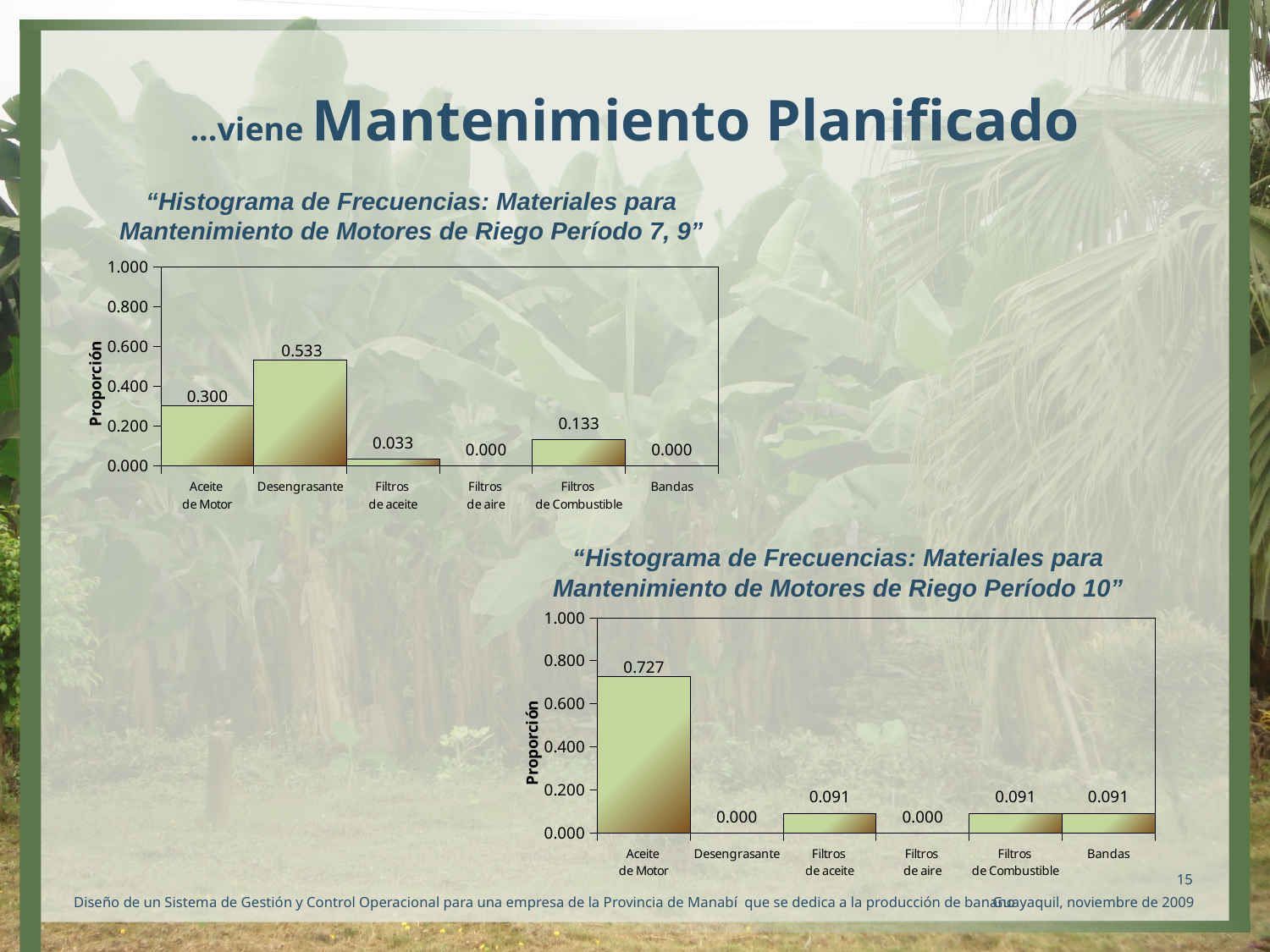
In the Período 7, 9 chart (top), which category has the highest proportion? Desengrasante In the Período 7, 9 chart (top), how many categories are shown on the x axis? 6 In the Período 10 chart (bottom), which category has the highest proportion? Aceite de Motor Which is larger: the proportion for Aceite de Motor in the Período 7, 9 chart or in the Período 10 chart? Período 10 chart In the Período 10 chart (bottom), is the proportion for Aceite de Motor greater or less than 0.600? greater What is the label on the vertical axis of the Período 7, 9 chart (top)? Proporción In the Período 7, 9 chart (top), what is the proportion for Desengrasante? 0.533 In the Período 10 chart (bottom), what is the proportion for Bandas? 0.091 What type of chart is the Período 10 chart (bottom)? Bar chart In the Período 7, 9 chart (top), what is the difference between the proportions for Desengrasante and Aceite de Motor? 0.233 In the Período 7, 9 chart (top), what is the proportion for Filtros de Combustible? 0.133 In the Período 10 chart (bottom), what is the proportion for Aceite de Motor? 0.727